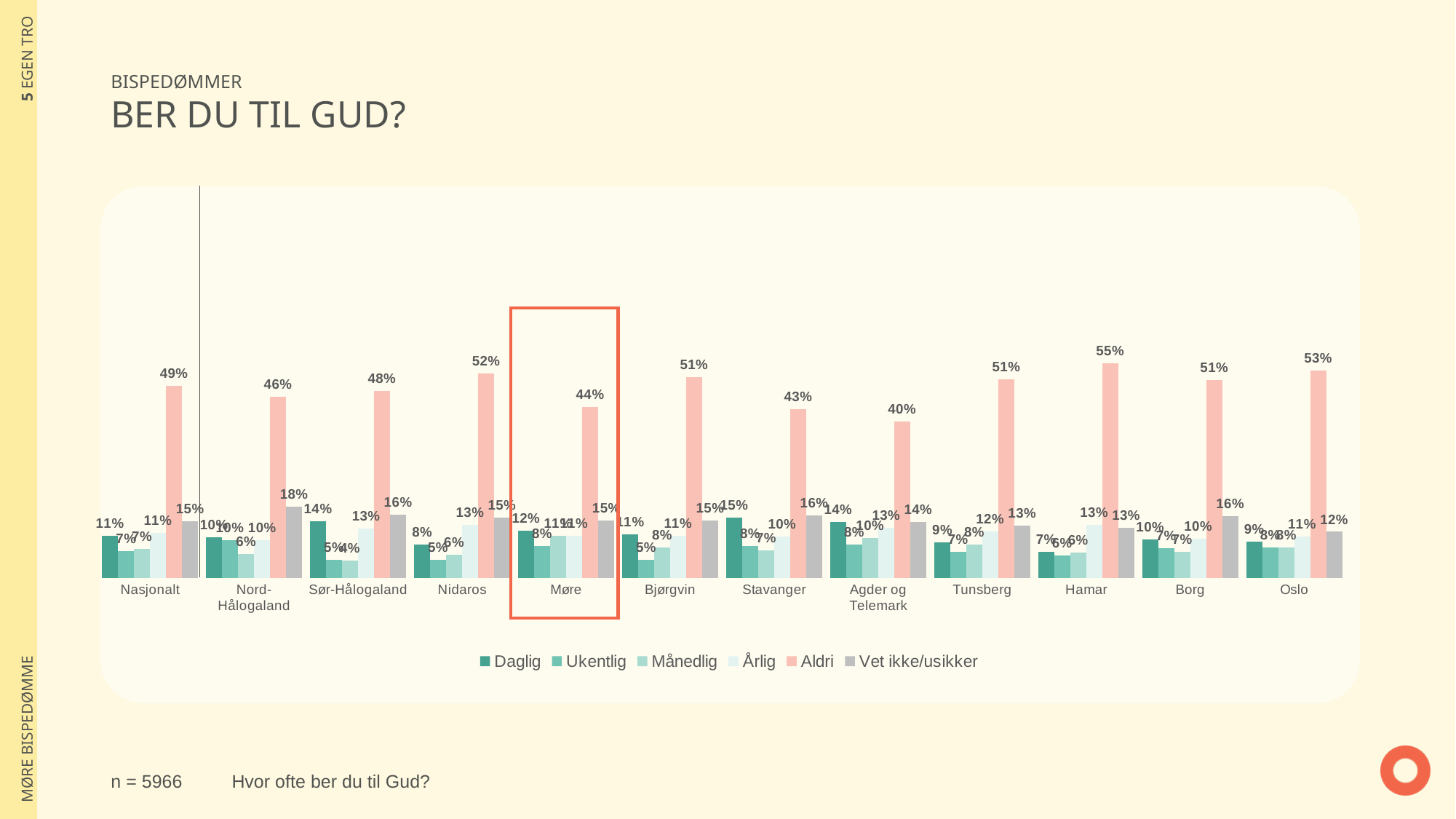
Which is larger, the Daglig value for Stavanger or the Daglig value for Hamar? Stavanger What kind of chart is shown on the slide? bar chart What is the Aldri value for Nasjonalt? 49% How many categories (bispedømmer, including Nasjonalt) are shown along the x axis? 12 What is the Daglig value for Stavanger? 15% Which category has the lowest Aldri value? Agder og Telemark Which category is highlighted with an orange box on the chart? Møre What is the difference between the Aldri value for Hamar and the Aldri value for Møre? 11 percentage points What is the Vet ikke/usikker value for Nord-Hålogaland? 18% Which category has the highest Aldri value? Hamar How many series does the legend list? 6 What is the value of Aldri for Møre? 44%